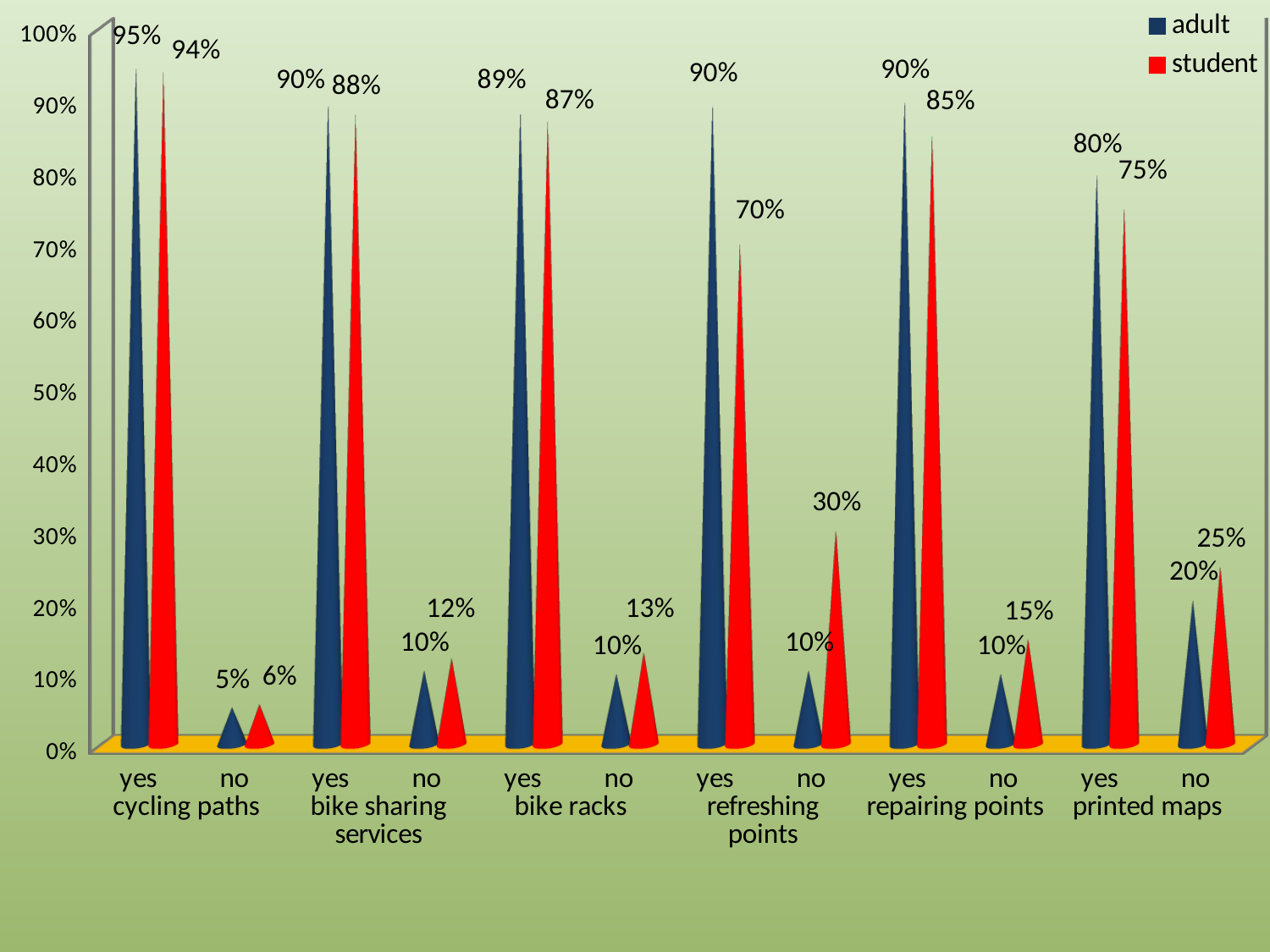
Which is larger for 'no' under bike racks, the adult value or the student value? student Which category has the highest adult value? yes, cycling paths Which colour represents the student series? red What is the student value for 'yes' under printed maps? 75% What is the student value for 'no' under refreshing points? 30% What kind of chart is this? bar chart How many categories are shown along the x axis? 12 What is the adult value for 'yes' under cycling paths? 95% How many series does the legend list? 2 What is the difference between the adult and student values for 'yes' under refreshing points? 20% Which category has the lowest student value? no, cycling paths What is the adult value for 'no' under printed maps? 20%